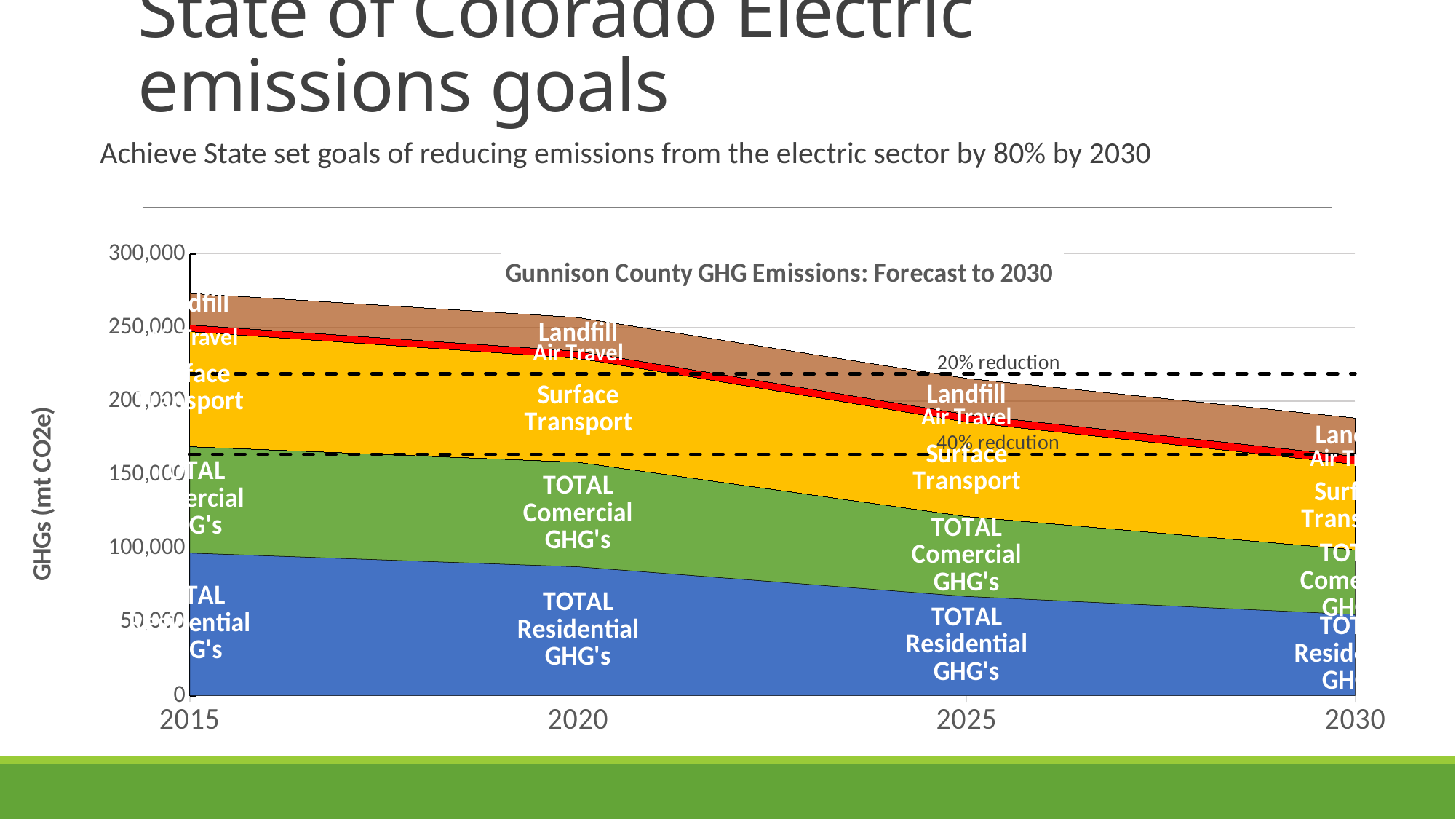
What is the title of the chart? Gunnison County GHG Emissions: Forecast to 2030 Is the total stacked emissions value in 2030 greater or less than 200,000? less Is the top of the TOTAL Comercial GHG's band in 2015 greater or less than 150,000? greater What kind of chart is shown on the slide? Stacked area chart Which category forms the bottom (blue) band of the stacked chart? TOTAL Residential GHG's How many emission categories are stacked in the chart? 5 Is the total stacked emissions value in 2015 greater or less than 250,000? greater Do total GHG emissions rise or fall from 2015 to 2030 in the chart? Fall How many years are labelled on the x axis of the chart? 4 What is the label on the vertical axis of the chart? GHGs (mt CO2e)